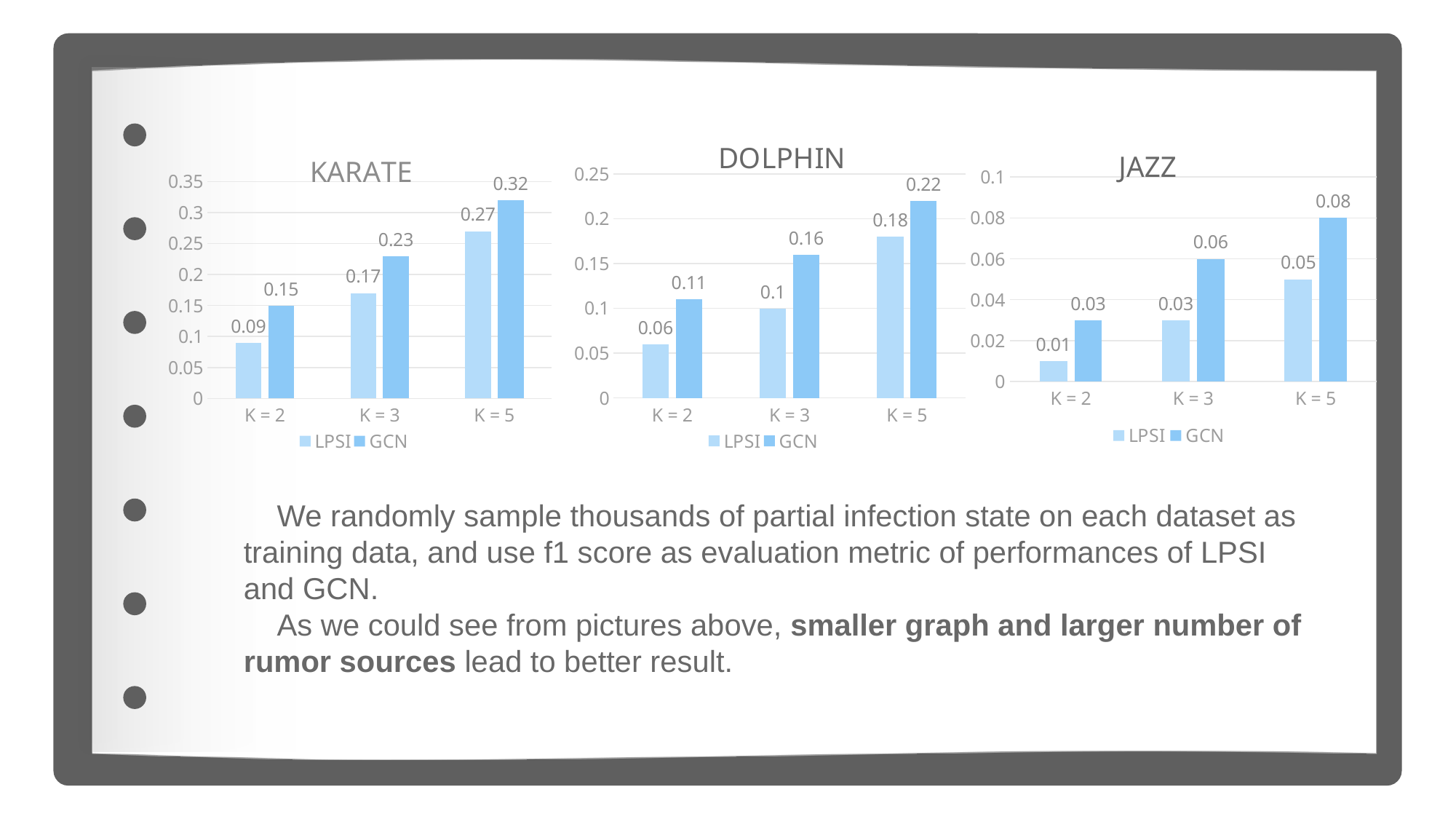
In the KARATE chart, what is the GCN value for K = 5? 0.32 In the DOLPHIN chart, what is the LPSI value for K = 3? 0.1 How many categories are shown on the x axis of the JAZZ chart? 3 How many series does the legend of the DOLPHIN chart list? 2 In the JAZZ chart, what is the difference between the GCN and LPSI values for K = 5? 0.03 In the DOLPHIN chart, which category has the highest GCN value? K = 5 In the KARATE chart, which category has the lowest LPSI value? K = 2 What kind of chart is the KARATE chart? Bar chart In the DOLPHIN chart, which is larger for K = 2: the LPSI value or the GCN value? GCN In the JAZZ chart, do the GCN values rise or fall from K = 2 to K = 5? Rise In the JAZZ chart, what is the LPSI value for K = 2? 0.01 In the KARATE chart, what is the difference between the GCN value for K = 5 and the GCN value for K = 2? 0.17